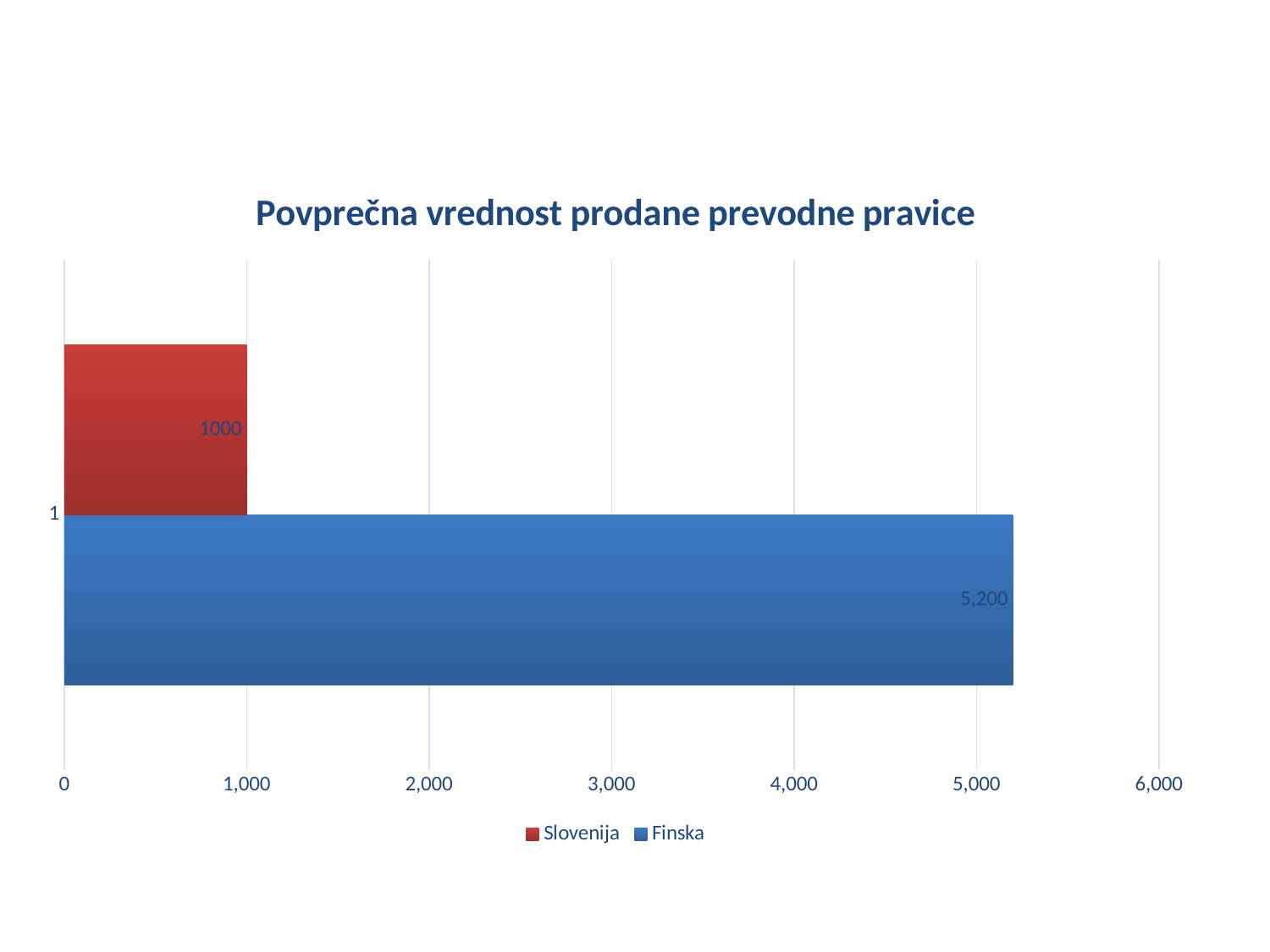
What is the difference between the values for Finska and Slovenija? 4,200 What kind of chart is shown on the slide? bar chart What is the title of the chart? Povprečna vrednost prodane prevodne pravice What colour is the bar for Finska? blue How many series does the legend list? 2 Which series has the higher value, Slovenija or Finska? Finska What is the value for Slovenija? 1000 Is the value for Slovenija greater or less than 2,000? less Which series has the lowest value? Slovenija What is the highest value shown on the x axis? 6,000 Is the value for Finska greater or less than 5,000? greater What is the value for Finska? 5,200